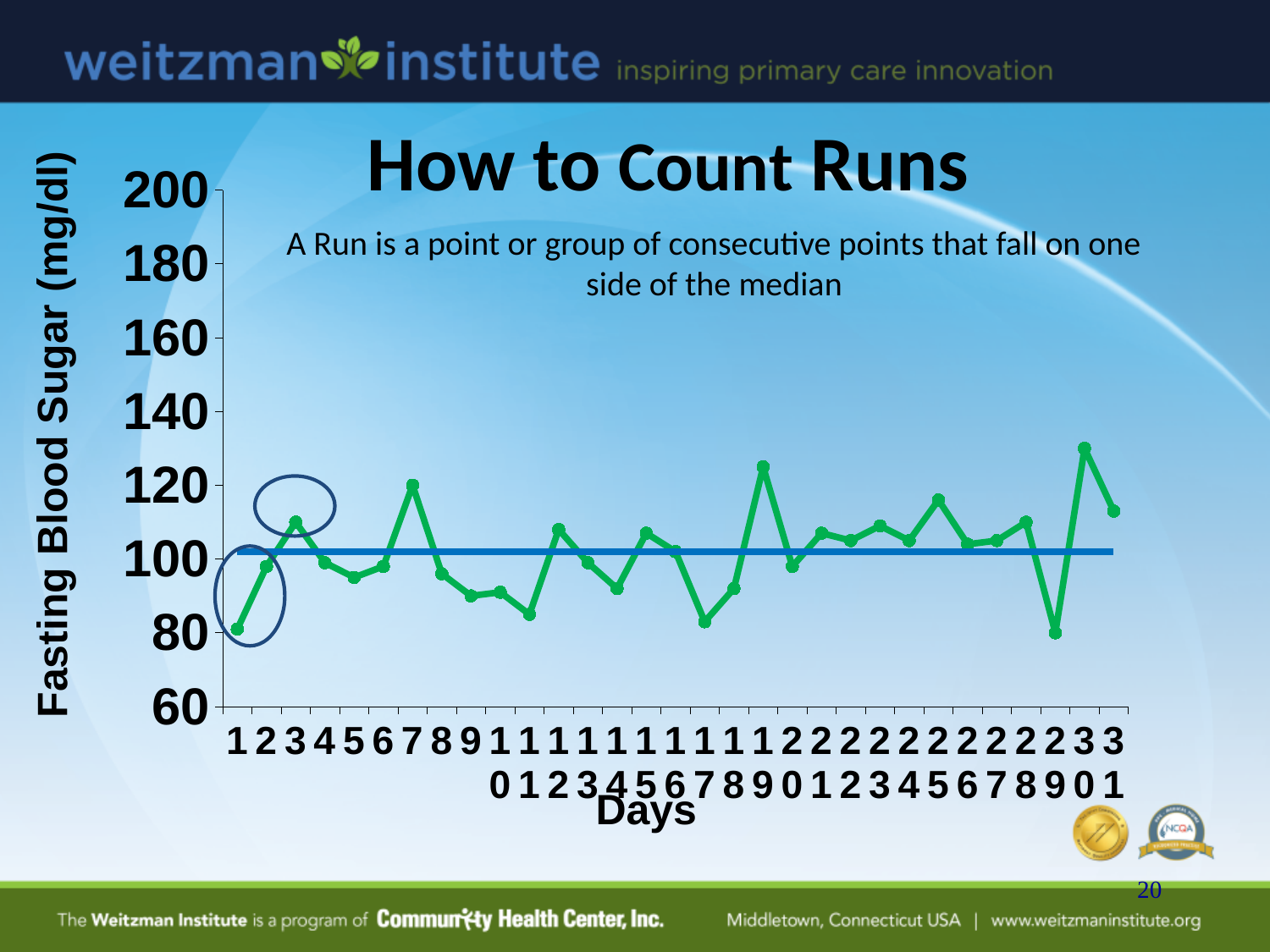
What kind of chart is shown on the slide? line chart Is the value for day 1 greater or less than 100? less Is the value for day 17 greater or less than 100? less Which is larger, the value for day 19 or the value for day 20? day 19 Is the value for day 7 greater or less than 100? greater What is the label on the vertical axis of the chart? Fasting Blood Sugar (mg/dl) How many days (data points) are plotted on the chart? 31 Which is larger, the value for day 29 or the value for day 30? day 30 Which is larger, the value for day 7 or the value for day 8? day 7 What is the title of the chart? How to Count Runs